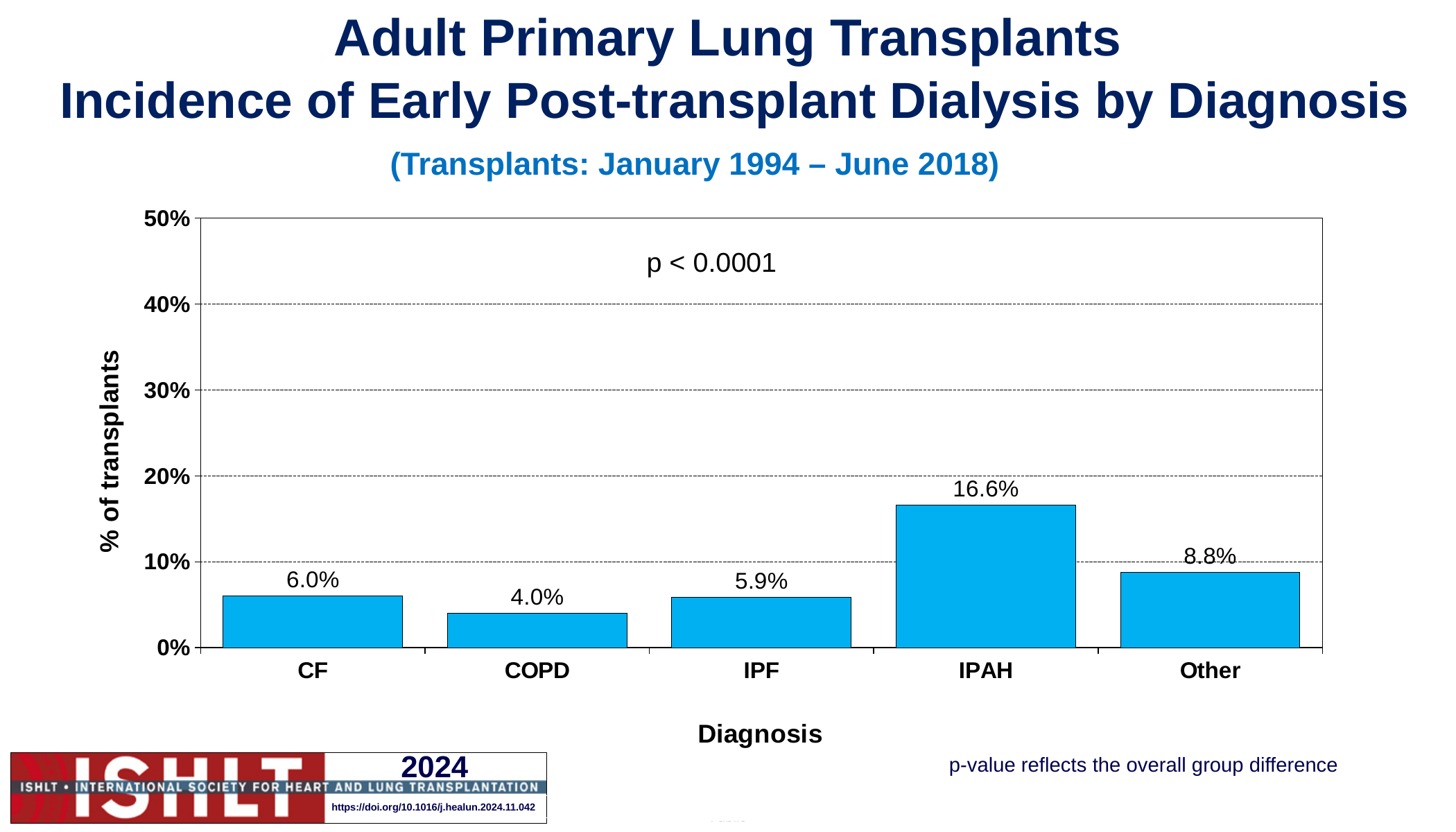
What is the label of the y axis? % of transplants What kind of chart is shown on the slide? bar chart Which diagnosis has the lowest incidence of early post-transplant dialysis? COPD What is the incidence of early post-transplant dialysis for IPAH? 16.6% How many diagnosis categories are shown on the x axis? 5 Which diagnosis has the highest incidence of early post-transplant dialysis? IPAH What is the difference between the values for Other and CF? 2.8% What is the value shown for COPD? 4.0% Is the value for IPAH greater or less than 10%? greater What is the value shown for the Other diagnosis group? 8.8% What is the difference between the values for IPAH and COPD? 12.6% Which has a larger value, IPAH or Other? IPAH